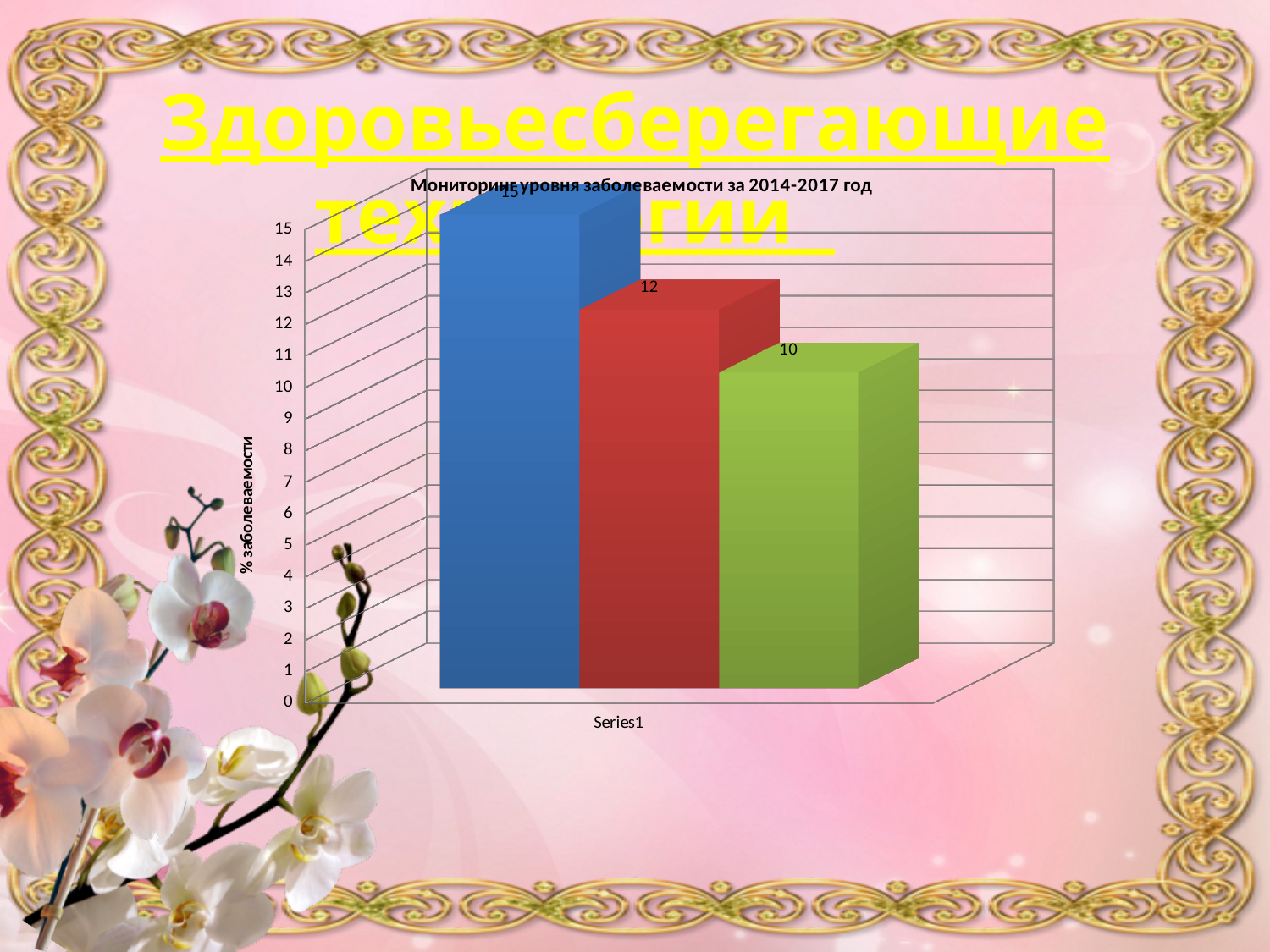
Which is larger, the red bar or the green bar? the red bar What is the value shown on the blue bar? 15 What is the value shown on the green bar? 10 How many bars are plotted in the chart? 3 Which bar has the lowest value? the green bar Which bar has the highest value? the blue bar What is the difference between the red bar and the green bar? 2 Do the bar values rise or fall from left to right? fall What is the value shown on the red bar? 12 What kind of chart is shown on the slide? bar chart What is the difference between the blue bar and the green bar? 5 What is the title of the chart? Мониторинг уровня заболеваемости за 2014-2017 год